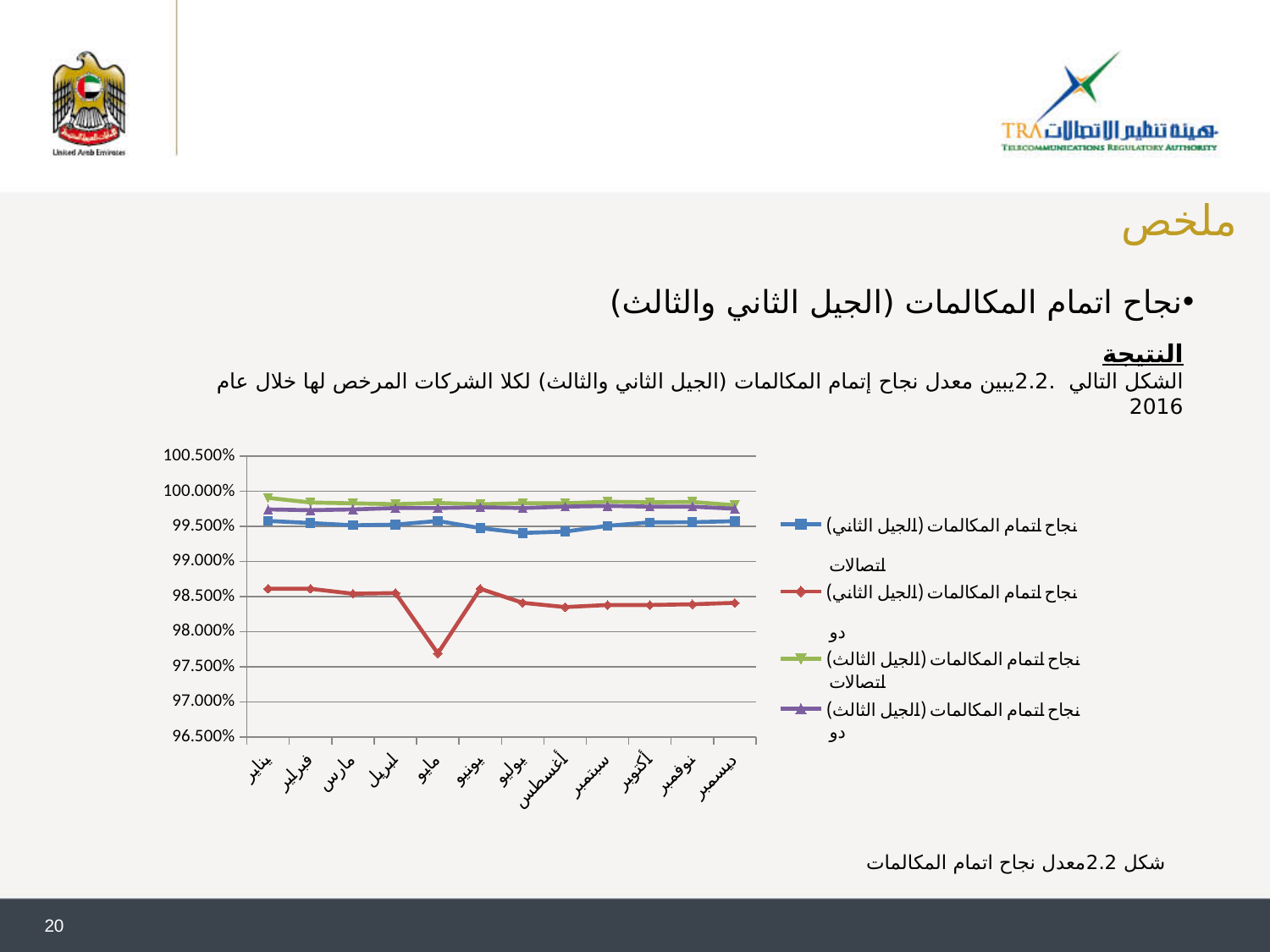
Is the value for نجاح اتمام المكالمات (الجيل الثاني) دو in مايو greater or less than 98.000%? less What colour is the line for نجاح اتمام المكالمات (الجيل الثاني) دو in the chart? red What kind of chart is shown on the slide? line chart In يناير, which is higher: نجاح اتمام المكالمات (الجيل الثاني) اتصالات or نجاح اتمام المكالمات (الجيل الثاني) دو? نجاح اتمام المكالمات (الجيل الثاني) اتصالات How many months are plotted along the x axis of the chart? 12 Which series has the lowest values across the year in the chart? نجاح اتمام المكالمات (الجيل الثاني) دو Is the value for نجاح اتمام المكالمات (الجيل الثاني) دو in يناير greater or less than 99.000%? less What is the lowest value shown on the y axis of the chart? 96.500% Is the value for نجاح اتمام المكالمات (الجيل الثالث) اتصالات in يناير greater or less than 99.500%? greater In which month does the series نجاح اتمام المكالمات (الجيل الثاني) دو reach its lowest value? مايو How many series does the chart legend list? 4